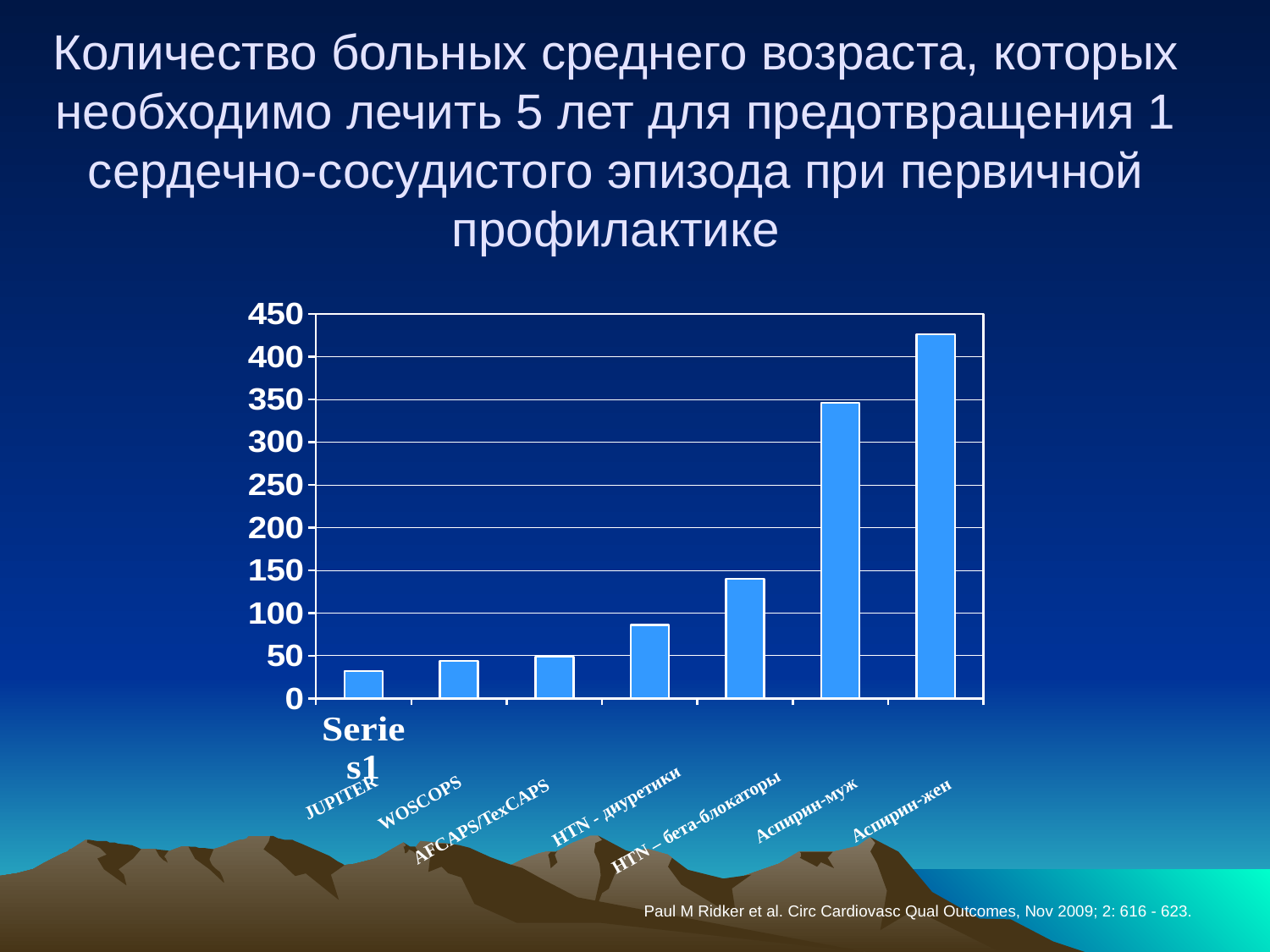
How many categories (bars) are plotted in the chart? 7 Which category has the highest bar in the chart? Аспирин-жен Do the bar values rise or fall from left to right along the x axis? rise Which category has the lowest bar in the chart? JUPITER Is the value for Аспирин-жен greater or less than 400? greater Is the value for JUPITER greater or less than 50? less Is the value for HTN - диуретики greater or less than 100? less What kind of chart is shown on the slide? bar chart Which bar is taller: Аспирин-муж or Аспирин-жен? Аспирин-жен Which bar is taller: HTN - диуретики or HTN – бета-блокаторы? HTN – бета-блокаторы